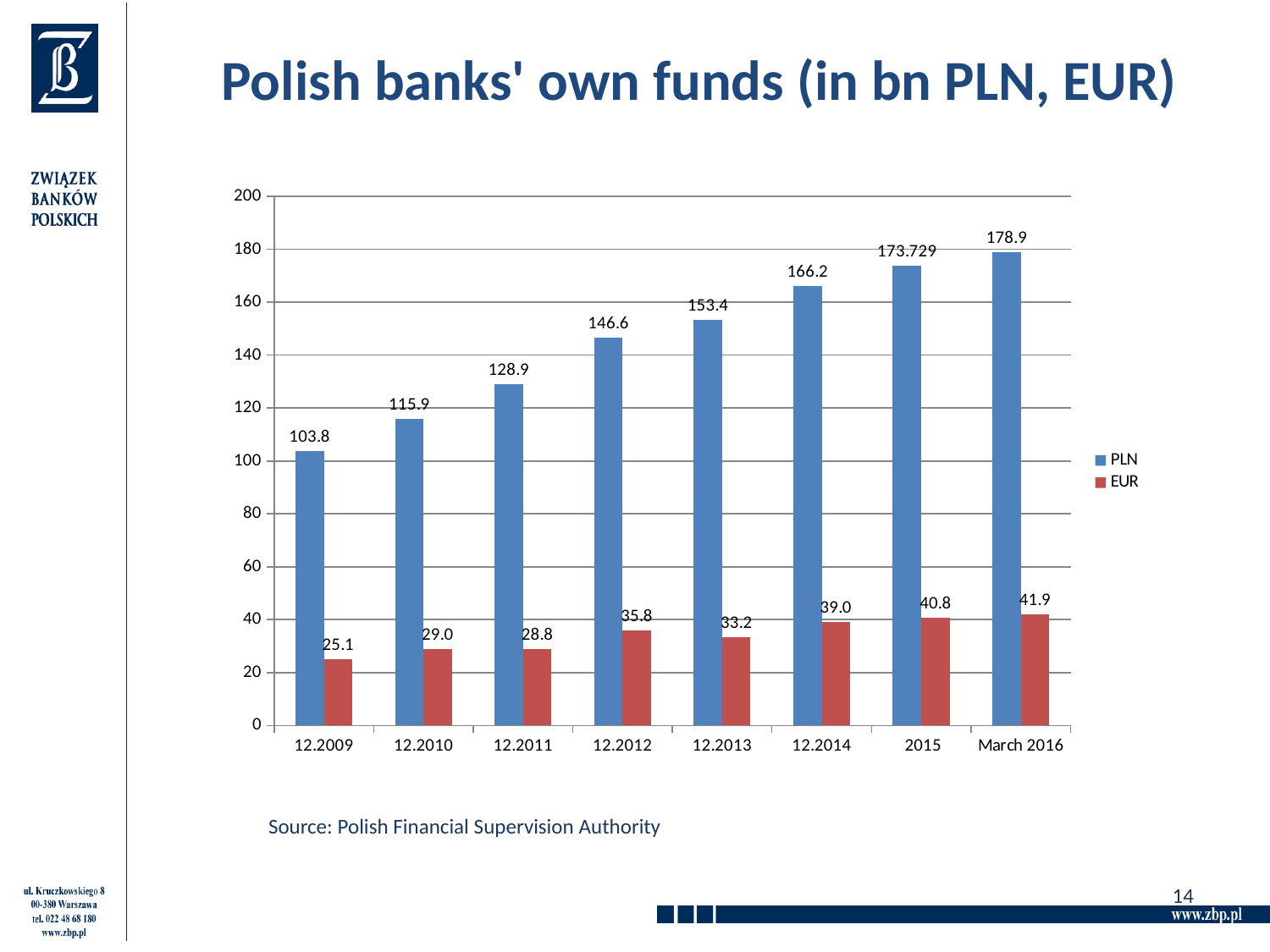
How many series does the legend list? 2 What is the EUR value for 12.2014? 39.0 Do the PLN values rise or fall from 12.2009 to March 2016? rise Is the PLN value for 12.2013 greater or less than 140? greater What is the PLN value for 2015? 173.729 What kind of chart is shown on the slide? bar chart What is the difference between the PLN values for March 2016 and 12.2009? 75.1 Which category has the lowest EUR value? 12.2009 How many categories are shown on the x axis? 8 Which category has the highest PLN value? March 2016 What is the PLN value for 12.2012? 146.6 Which is larger, the EUR value for 12.2011 or for 12.2010? 12.2010